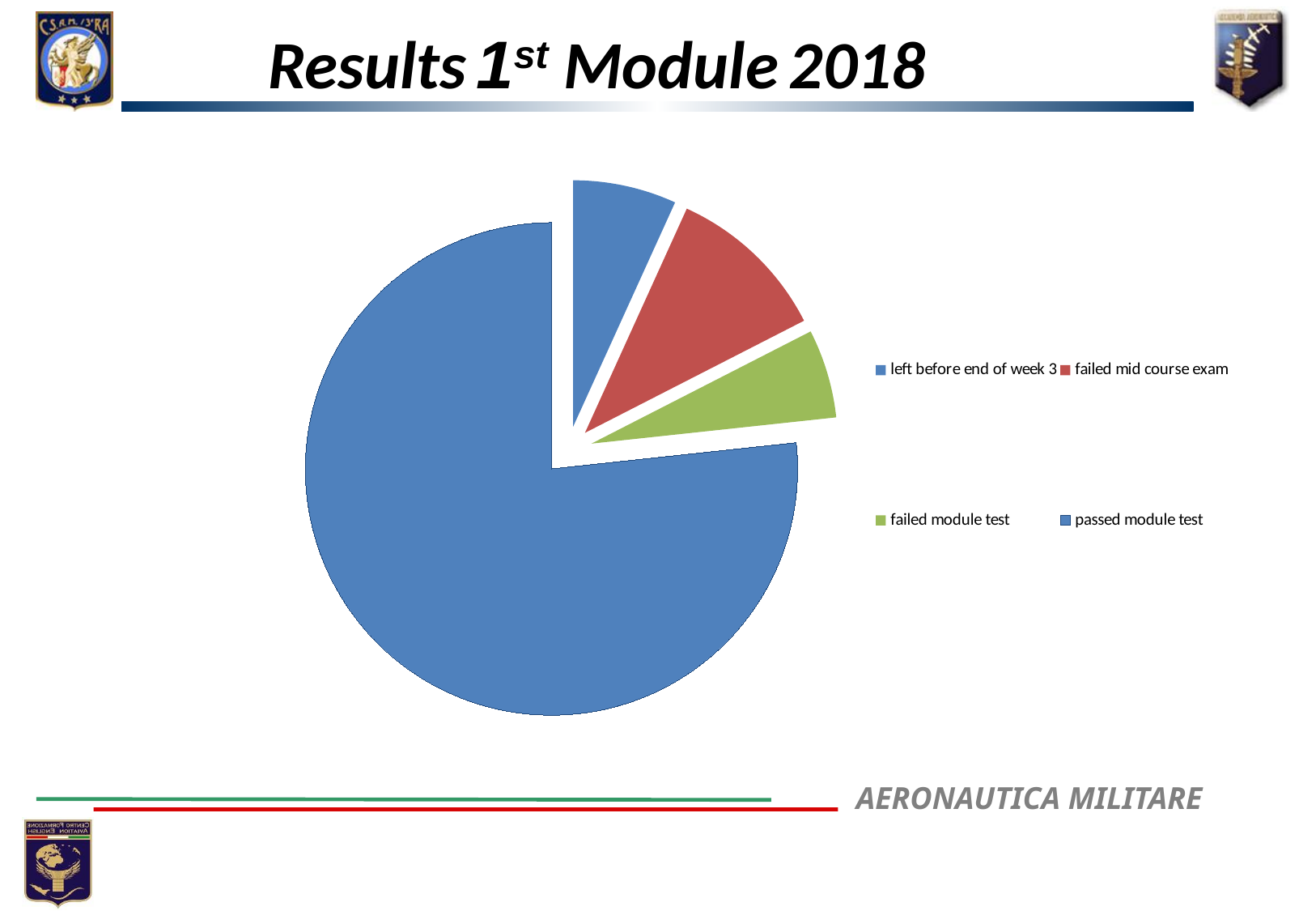
What is the title of the slide containing the pie chart? Results 1st Module 2018 What kind of chart is shown on the slide? pie chart Which slice is larger, failed mid course exam or failed module test? failed mid course exam Which slice is larger, failed mid course exam or passed module test? passed module test What colour is the slice for failed module test? green How many entries does the legend of the pie chart list? 4 Which category has the largest slice of the pie chart? passed module test Which slice is larger, passed module test or left before end of week 3? passed module test How many slices does the pie chart have? 4